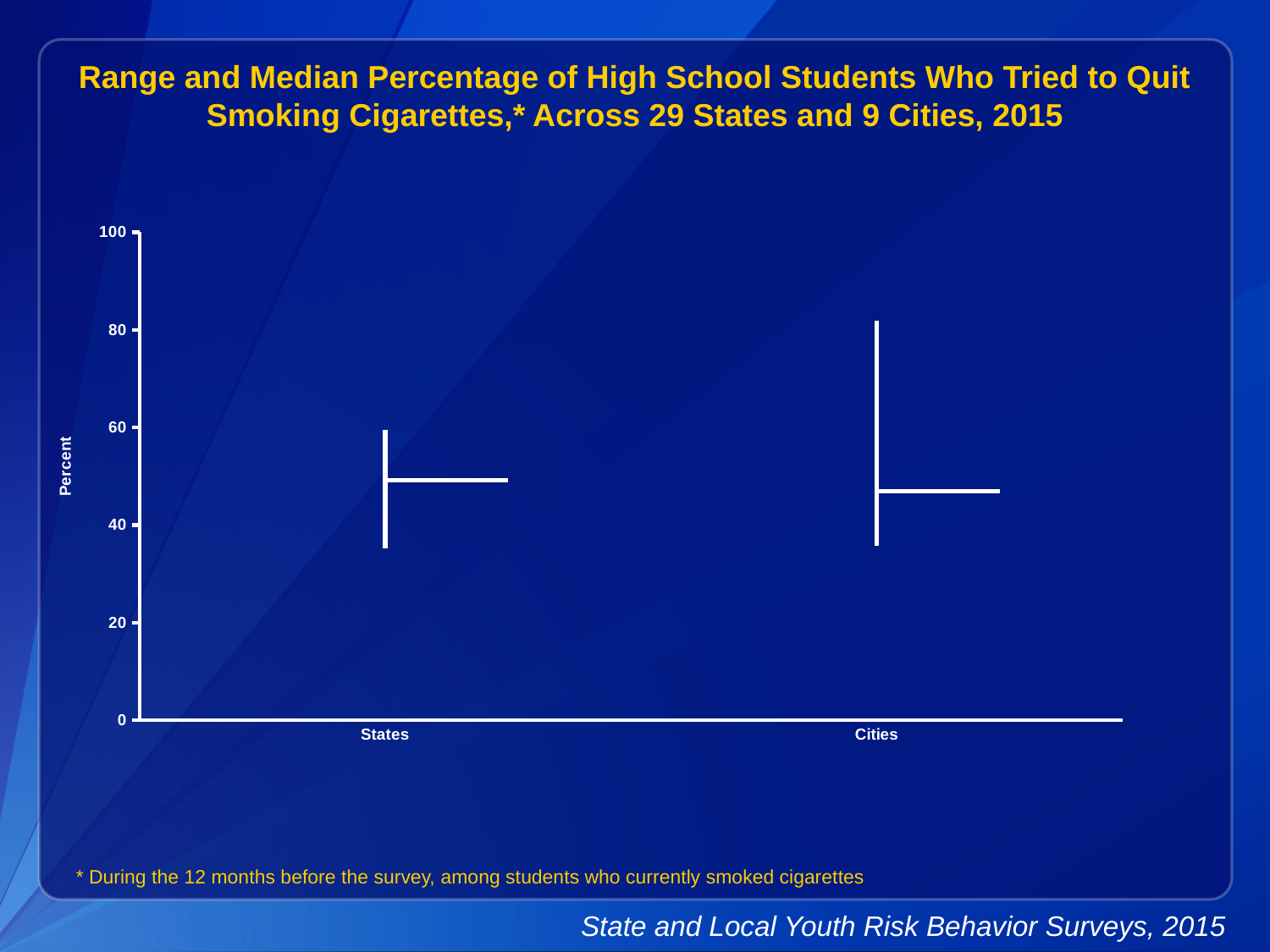
What is the title of the chart? Range and Median Percentage of High School Students Who Tried to Quit Smoking Cigarettes,* Across 29 States and 9 Cities, 2015 Is the maximum value for Cities greater or less than 60? greater Is the minimum value for States greater or less than 40? less What is the highest value shown on the vertical axis? 100 Is the minimum value for Cities greater or less than 40? less How many categories are shown on the x axis? 2 What kind of chart is this? Range and median (high-low) chart Which category has the higher maximum value, States or Cities? Cities What is the label on the vertical axis? Percent